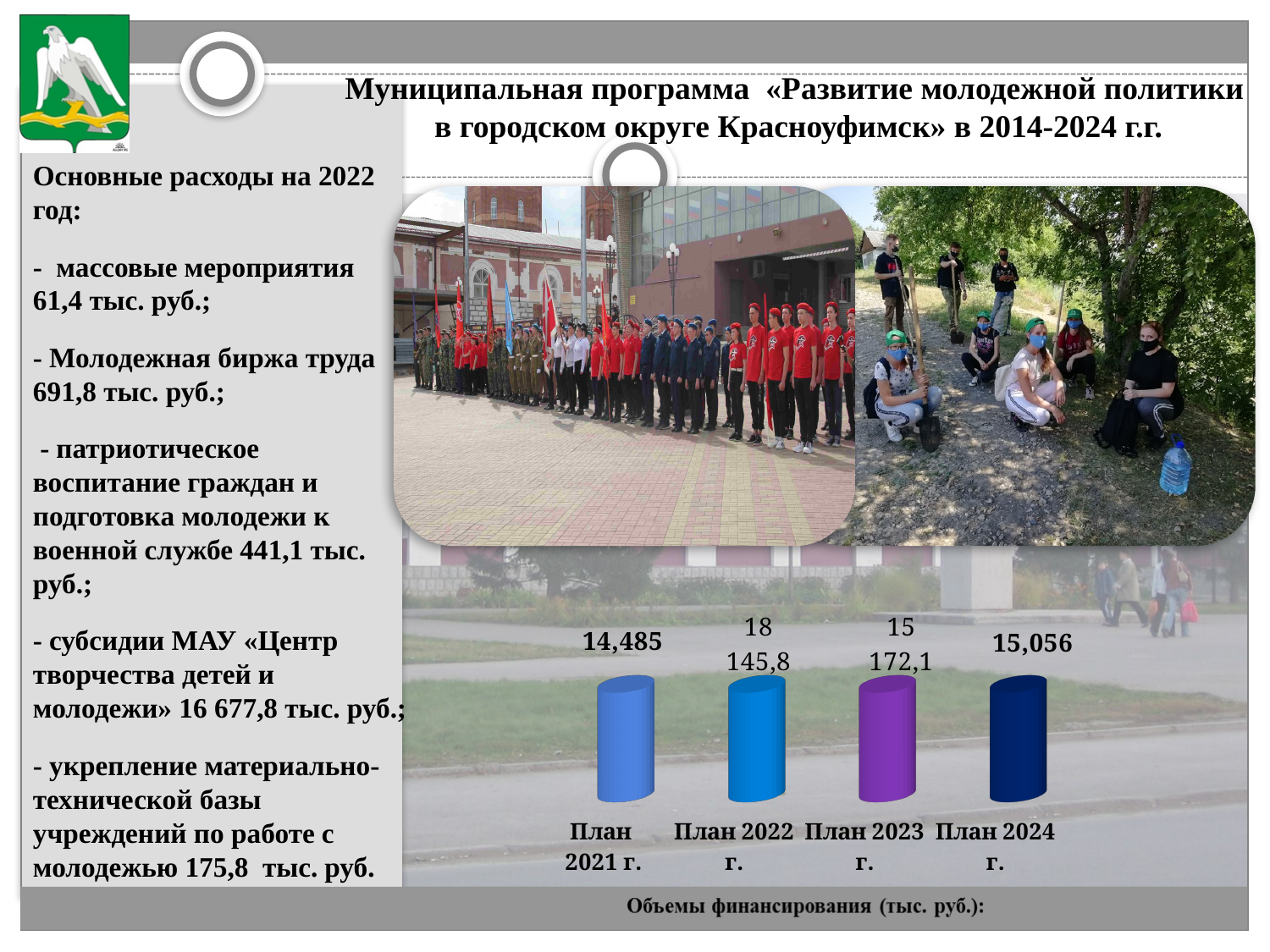
What kind of chart is shown on the slide? Bar chart Which is larger, the value for План 2022 г. or the value for План 2023 г.? План 2022 г. What is the title of the chart? Объемы финансирования (тыс. руб.): How many categories (bars) are shown in the chart? 4 What is the value shown for План 2021 г.? 14,485 What is the value shown for План 2024 г.? 15,056 What is the value shown for План 2022 г.? 18 145,8 What is the value shown for План 2023 г.? 15 172,1 What colour is the bar for План 2023 г.? Purple What is the difference between the values for План 2022 г. and План 2023 г.? 2 973,7